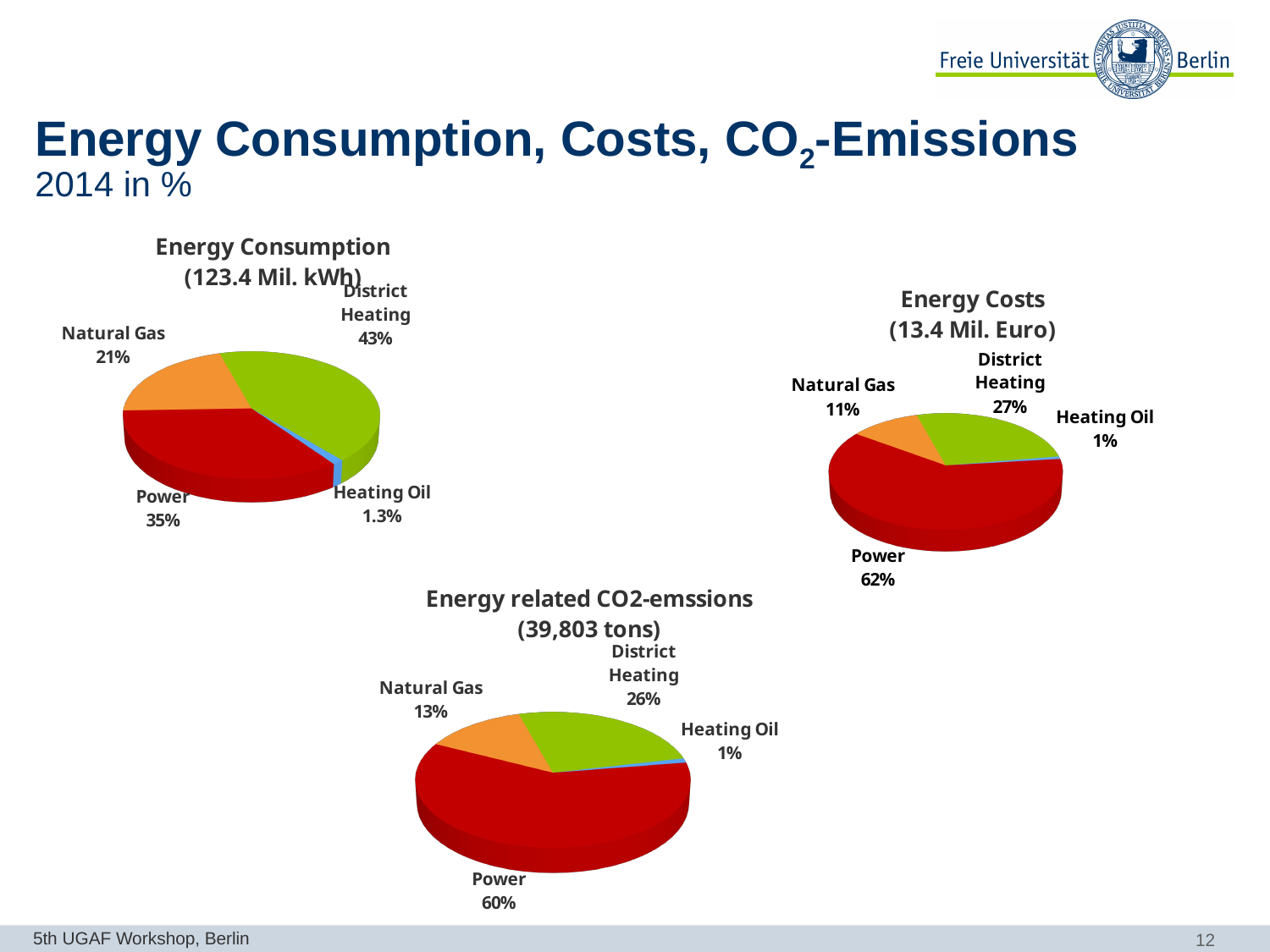
In the Energy Costs chart, which category has the smallest share? Heating Oil In the Energy Costs chart, what is the difference between the shares of Power and District Heating? 35% In the Energy related CO2-emssions chart, what share does Natural Gas have? 13% In the Energy Consumption chart, which is larger, the share of Power or the share of Natural Gas? Power What type of chart is the Energy Costs chart? Pie chart How many slices does the Energy related CO2-emssions chart have? 4 In the Energy Consumption chart, what share does District Heating have? 43% In the Energy Consumption chart, which category has the largest share? District Heating In the Energy related CO2-emssions chart, which category has the largest share? Power What total value is given in the title of the Energy Costs chart? 13.4 Mil. Euro In the Energy Consumption chart, what share does Heating Oil have? 1.3% In the Energy Costs chart, what share does Power have? 62%